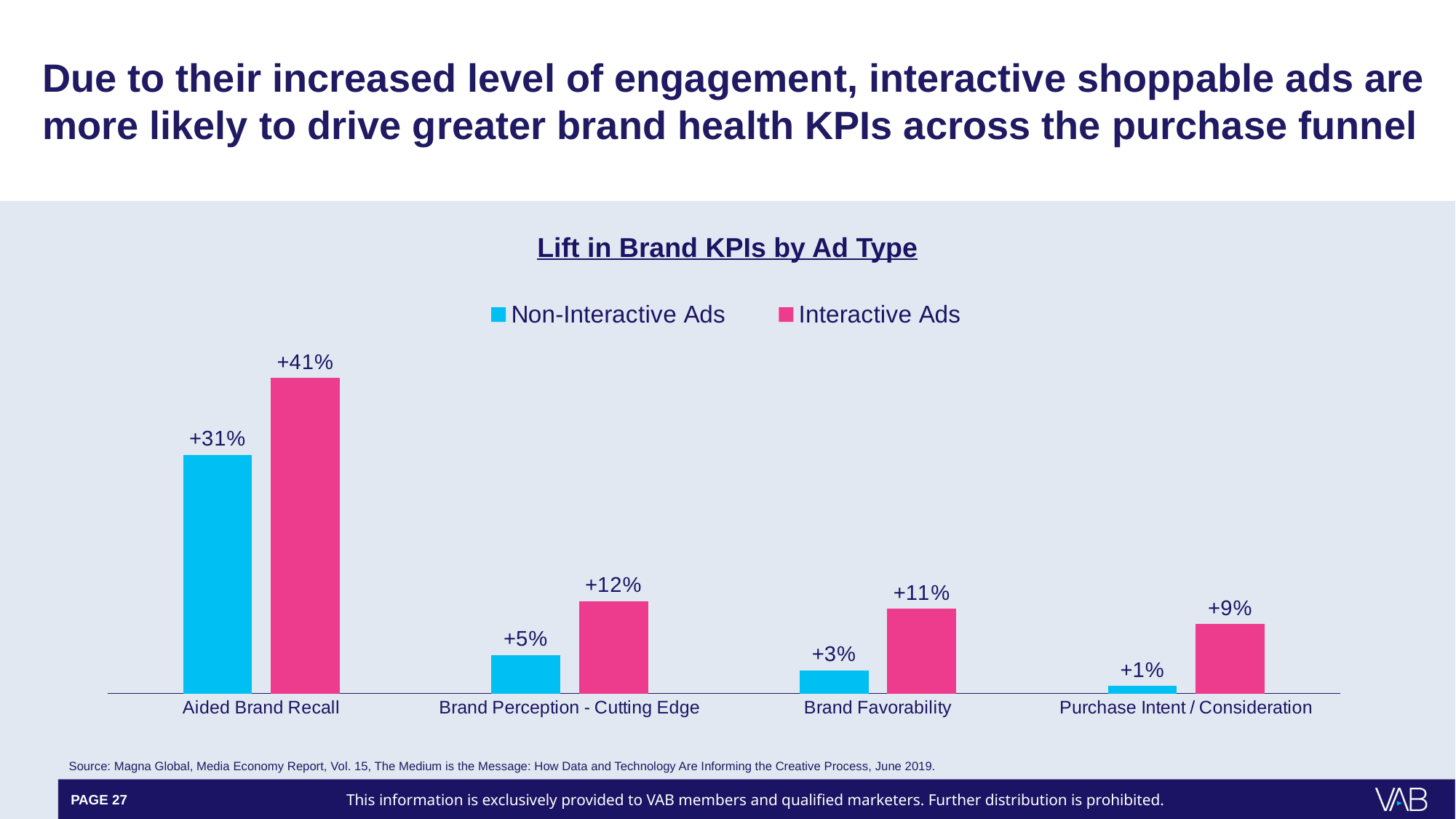
Which KPI shows the highest lift for Non-Interactive Ads? Aided Brand Recall Which KPI shows the lowest lift for Interactive Ads? Purchase Intent / Consideration What is the title of the chart? Lift in Brand KPIs by Ad Type What is the lift in Purchase Intent / Consideration for Interactive Ads? +9% Which colour represents Interactive Ads in the chart? Pink What kind of chart is shown on the slide? Bar chart For Brand Favorability, which ad type shows the larger lift? Interactive Ads What is the lift in Aided Brand Recall for Interactive Ads? +41% What is the difference between the Interactive Ads and Non-Interactive Ads lift for Brand Perception - Cutting Edge? 7 percentage points What is the lift in Brand Favorability for Non-Interactive Ads? +3% How many KPI categories are shown on the x axis? 4 How many series does the legend list? 2